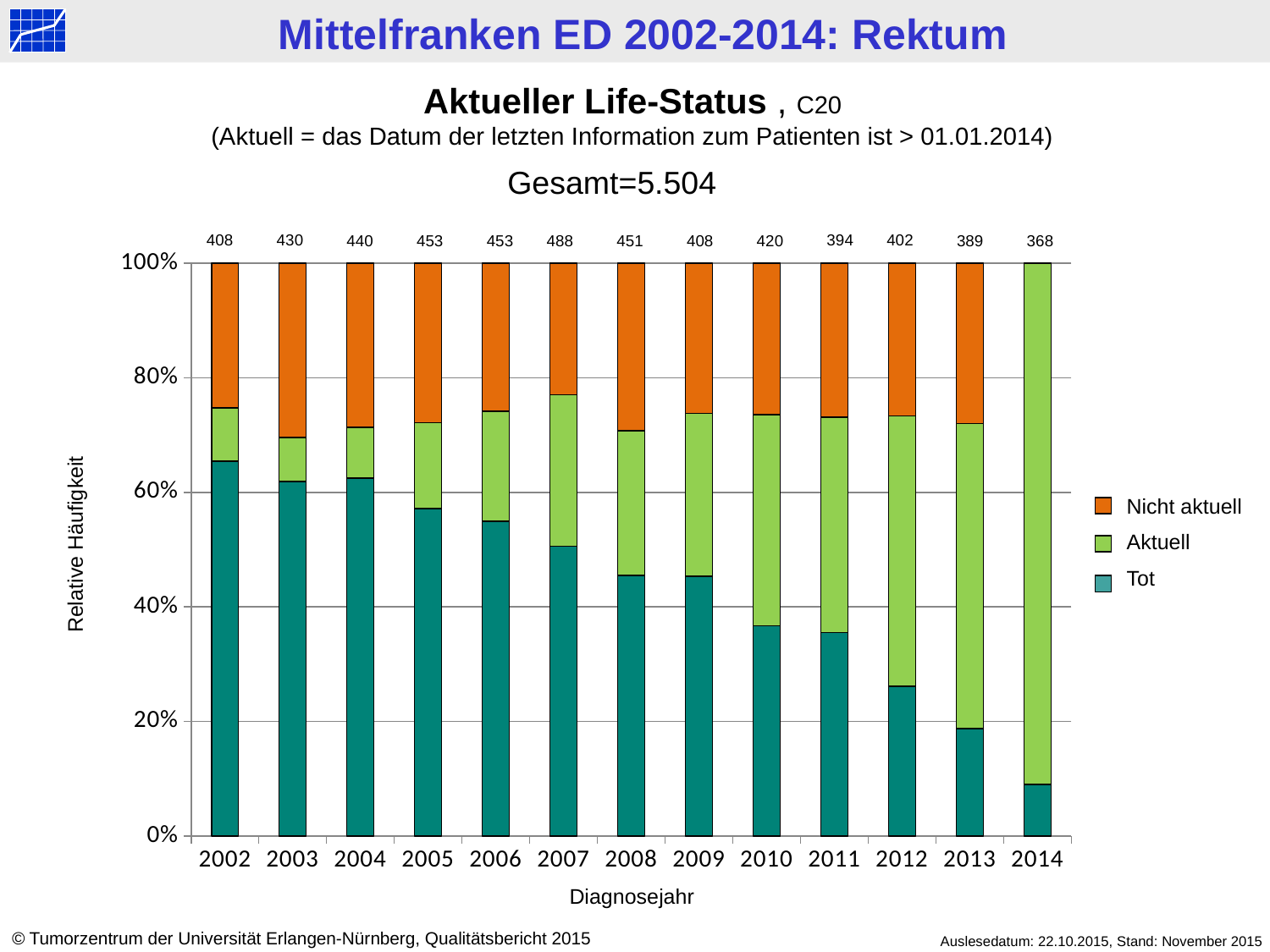
What is the number printed above the bar for 2014? 368 Does the 'Tot' share generally rise or fall from 2002 to 2014? Fall Which year has the larger number printed above its bar, 2003 or 2011? 2003 What is the number printed above the bar for 2007? 488 Is the 'Tot' share for 2002 greater or less than 60%? greater Which diagnosis year has the lowest number printed above its bar? 2014 How many series does the legend list? 3 Is the 'Tot' share for 2014 greater or less than 20%? less What kind of chart is shown on the slide? Stacked bar chart What is the difference between the numbers printed above the bars for 2007 and 2014? 120 Which diagnosis year has the highest number printed above its bar? 2007 How many diagnosis years are shown on the x axis? 13